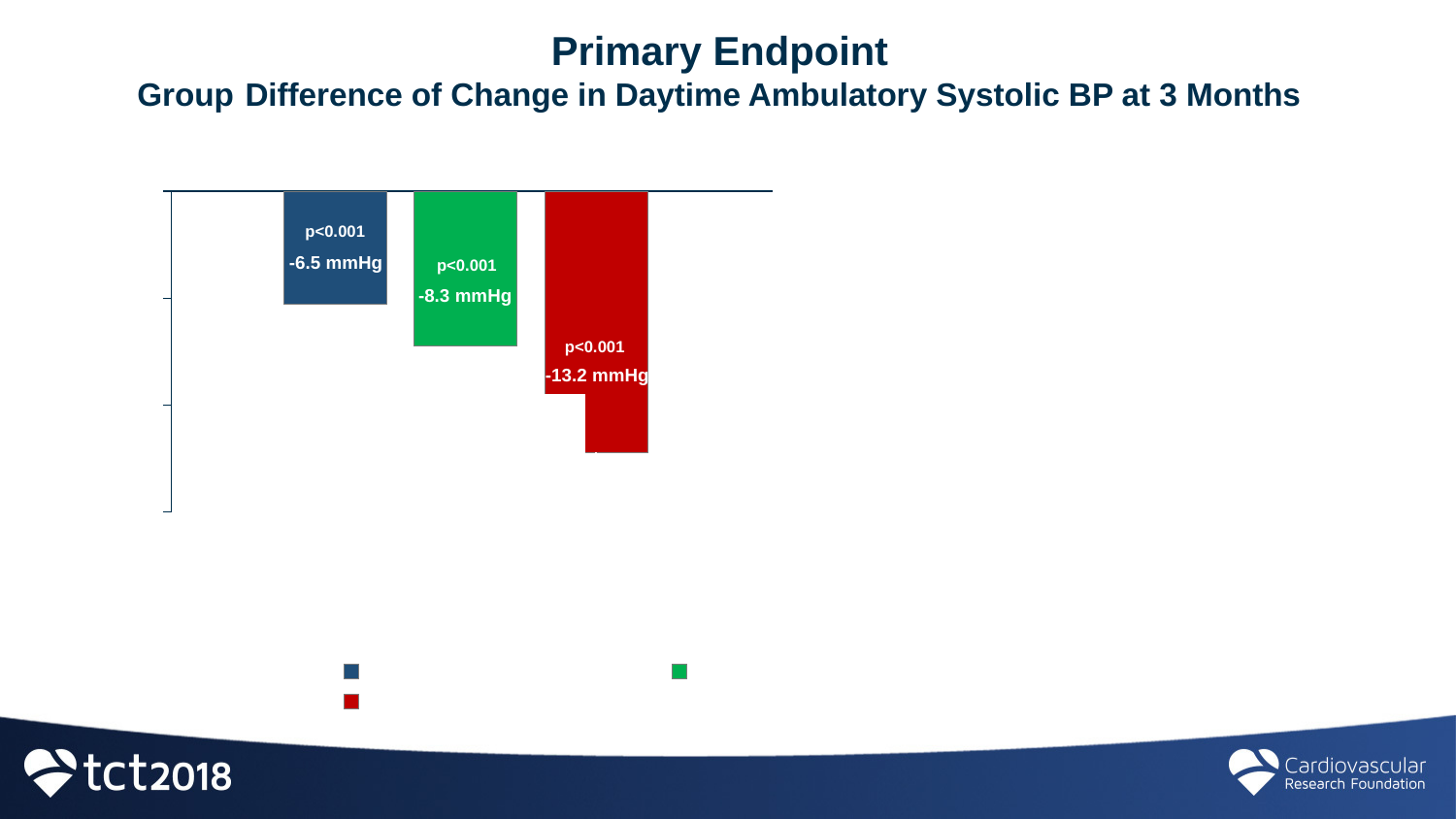
What is the difference in mmHg between the green bar's value and the blue bar's value? 1.8 mmHg What is the subtitle of the chart below 'Primary Endpoint'? Group Difference of Change in Daytime Ambulatory Systolic BP at 3 Months What is the difference in mmHg between the red bar's value and the blue bar's value? 6.7 mmHg What kind of chart is shown on the slide? Bar chart What value is labelled on the green bar? -8.3 mmHg What value is labelled on the red bar? -13.2 mmHg How many bars are plotted in the chart? 3 Which bar shows the smallest reduction in daytime ambulatory systolic BP? The blue bar (-6.5 mmHg) Which bar represents a larger reduction, the green bar or the blue bar? The green bar What value is labelled on the blue bar? -6.5 mmHg What p-value is printed on the red bar? p<0.001 Which bar shows the largest reduction in daytime ambulatory systolic BP? The red bar (-13.2 mmHg)